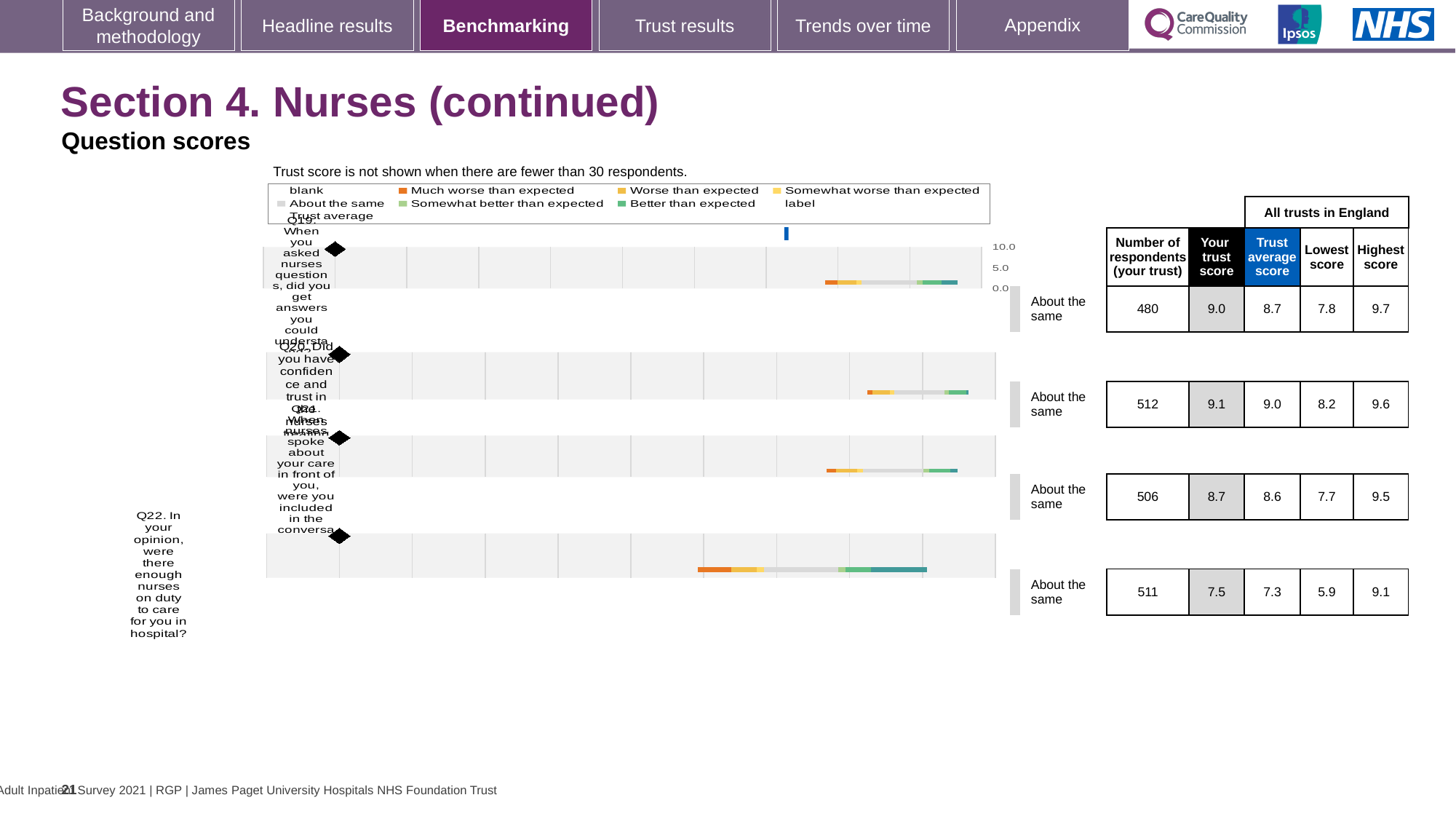
What is the highest score across all trusts in England for Q21? 9.5 Which question has the highest 'Your trust score' on this slide? Q20 How many respondents from your trust answered Q22 (were there enough nurses on duty)? 511 What is the maximum value shown on the chart's score axis? 10.0 What is the trust average score for Q22? 7.3 What is your trust score for Q20 (confidence and trust in the nurses)? 9.1 How many questions are plotted on the chart? 4 Which is larger: your trust score for Q19 or for Q21? Q19 What is the lowest score across all trusts in England for Q19? 7.8 Which question has the lowest 'Your trust score' on this slide? Q22 What benchmark category is shown for each of the four questions? About the same For Q22, how much higher is your trust score than the trust average score? 0.2